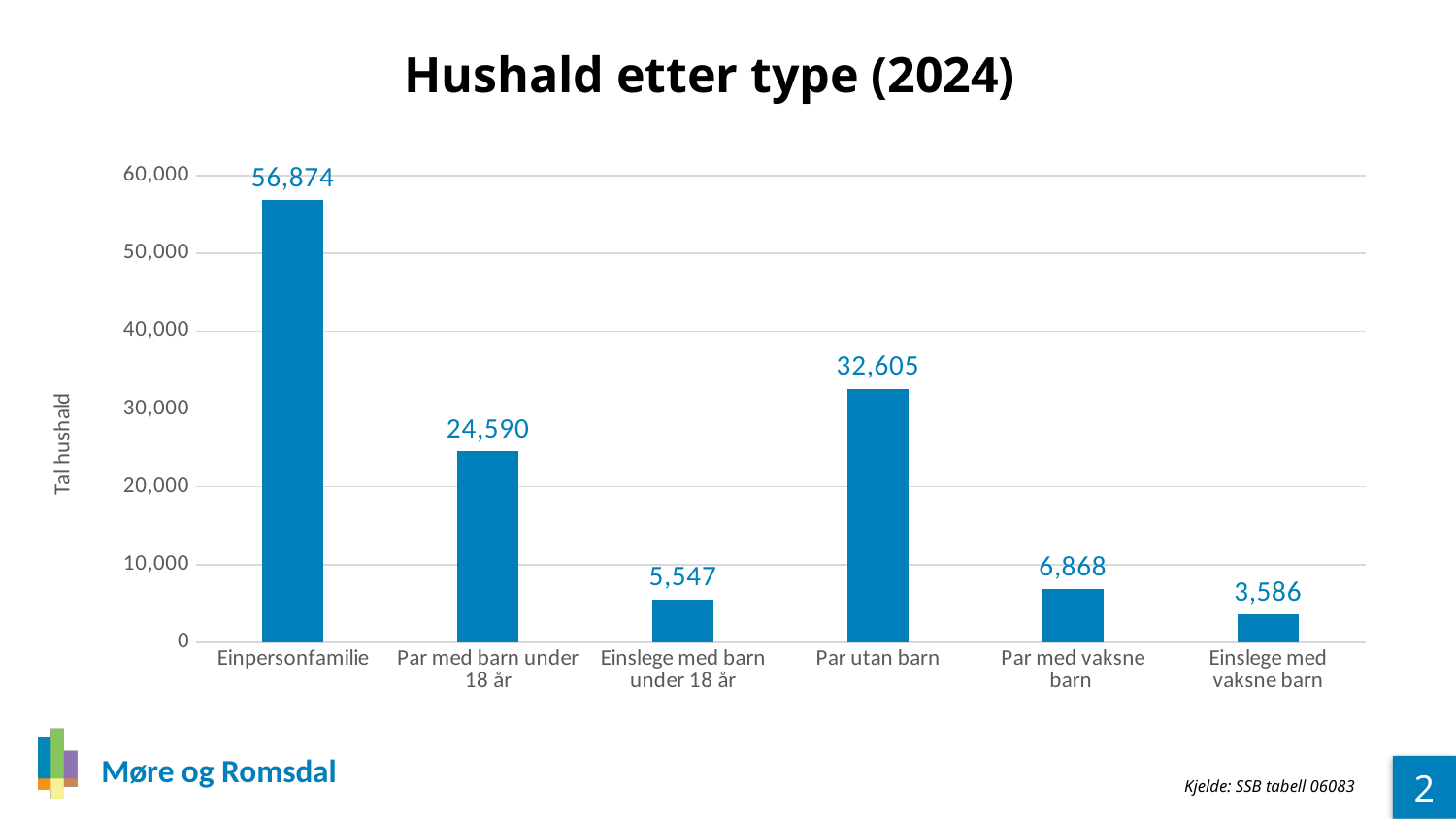
What is the value for Einpersonfamilie? 56,874 What is the value for Einslege med barn under 18 år? 5,547 What is the difference between Einpersonfamilie and Par utan barn? 24,269 How many household types are shown in the chart? 6 What is the difference between Par med vaksne barn and Einslege med vaksne barn? 3,282 Which is larger, Par med barn under 18 år or Par utan barn? Par utan barn Which household type has the highest value? Einpersonfamilie What is the value for Par med vaksne barn? 6,868 What is the value for Par utan barn? 32,605 What kind of chart is shown on the slide? Bar chart Which household type has the lowest value? Einslege med vaksne barn Is the value for Par med barn under 18 år greater or less than 20,000? greater